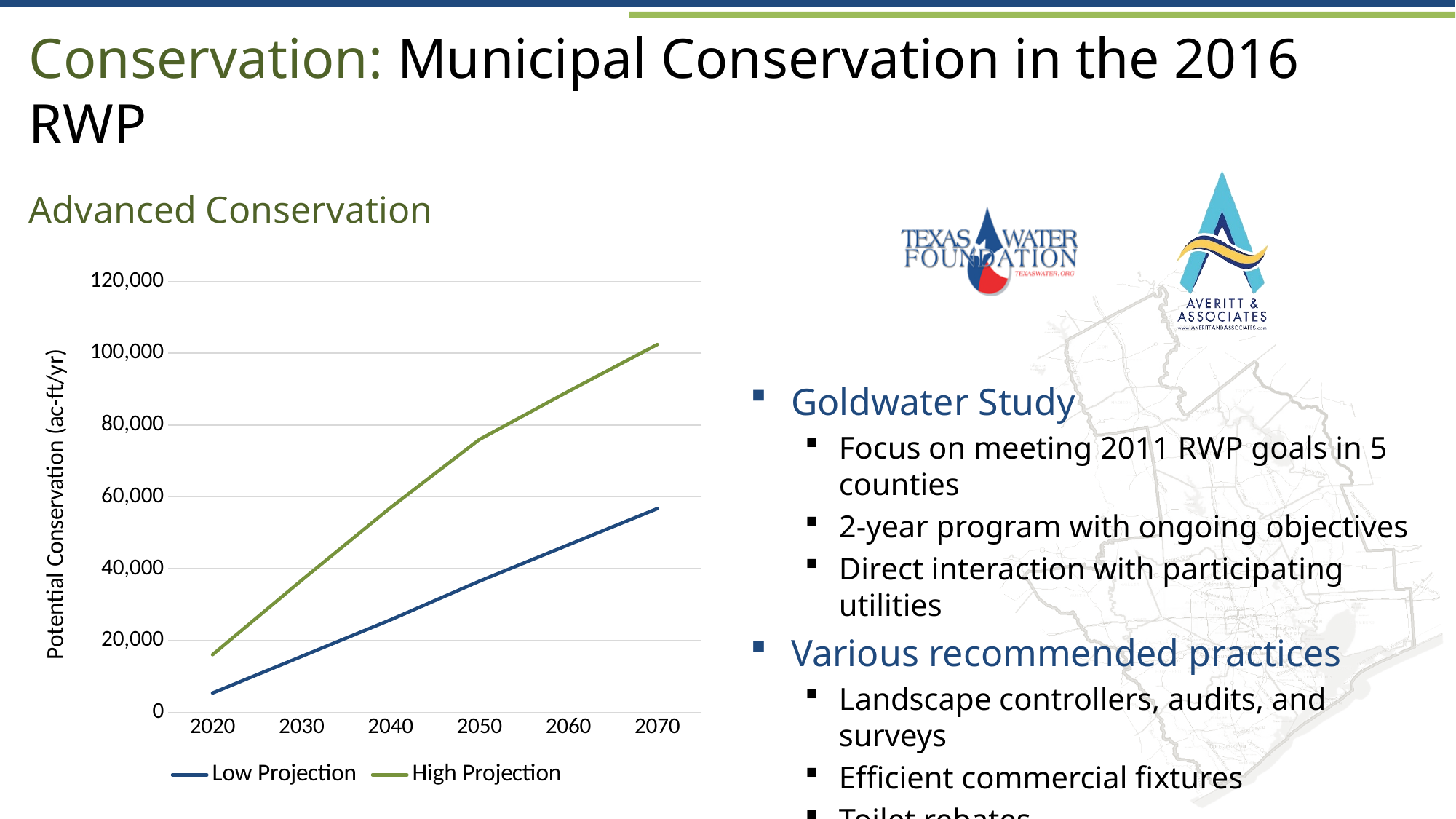
Is the High Projection value for 2070 greater or less than 80,000? greater What kind of chart is shown on the slide? line chart How many series does the chart legend list? 2 Is the Low Projection value for 2070 greater or less than 60,000? less Is the Low Projection value for 2020 greater or less than 20,000? less In 2070, which series has the larger value, Low Projection or High Projection? High Projection Does the Low Projection line rise or fall from 2020 to 2070? rise Does the High Projection line rise or fall from 2020 to 2070? rise How many years are labelled on the x axis of the chart? 6 What is the label of the y axis of the chart? Potential Conservation (ac-ft/yr) What are the names of the two series in the chart legend? Low Projection and High Projection